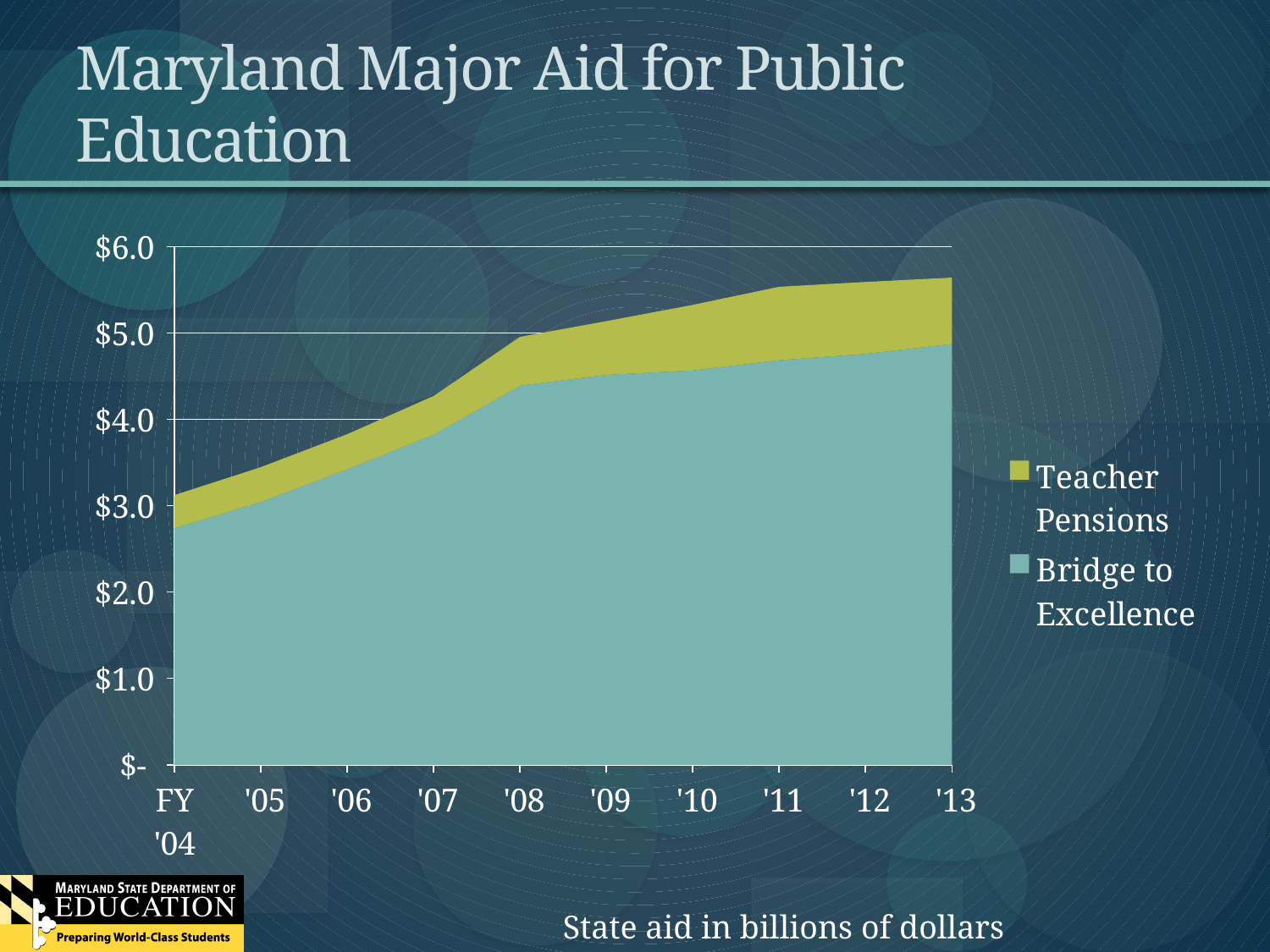
What kind of chart is shown on the slide? Stacked area chart Is the value for Bridge to Excellence in '08 greater or less than $4.0? greater In what units are the values on the chart expressed, according to the note below the chart? Billions of dollars Is the total state aid in '13 greater or less than $5.0? greater Which series is larger in every year, Teacher Pensions or Bridge to Excellence? Bridge to Excellence How many series does the legend list? 2 Is the total state aid in '11 greater or less than $5.0? greater What is the title of the chart on the slide? Maryland Major Aid for Public Education Does the total state aid rise or fall from FY '04 to '13? Rises How many fiscal years are plotted along the x axis? 10